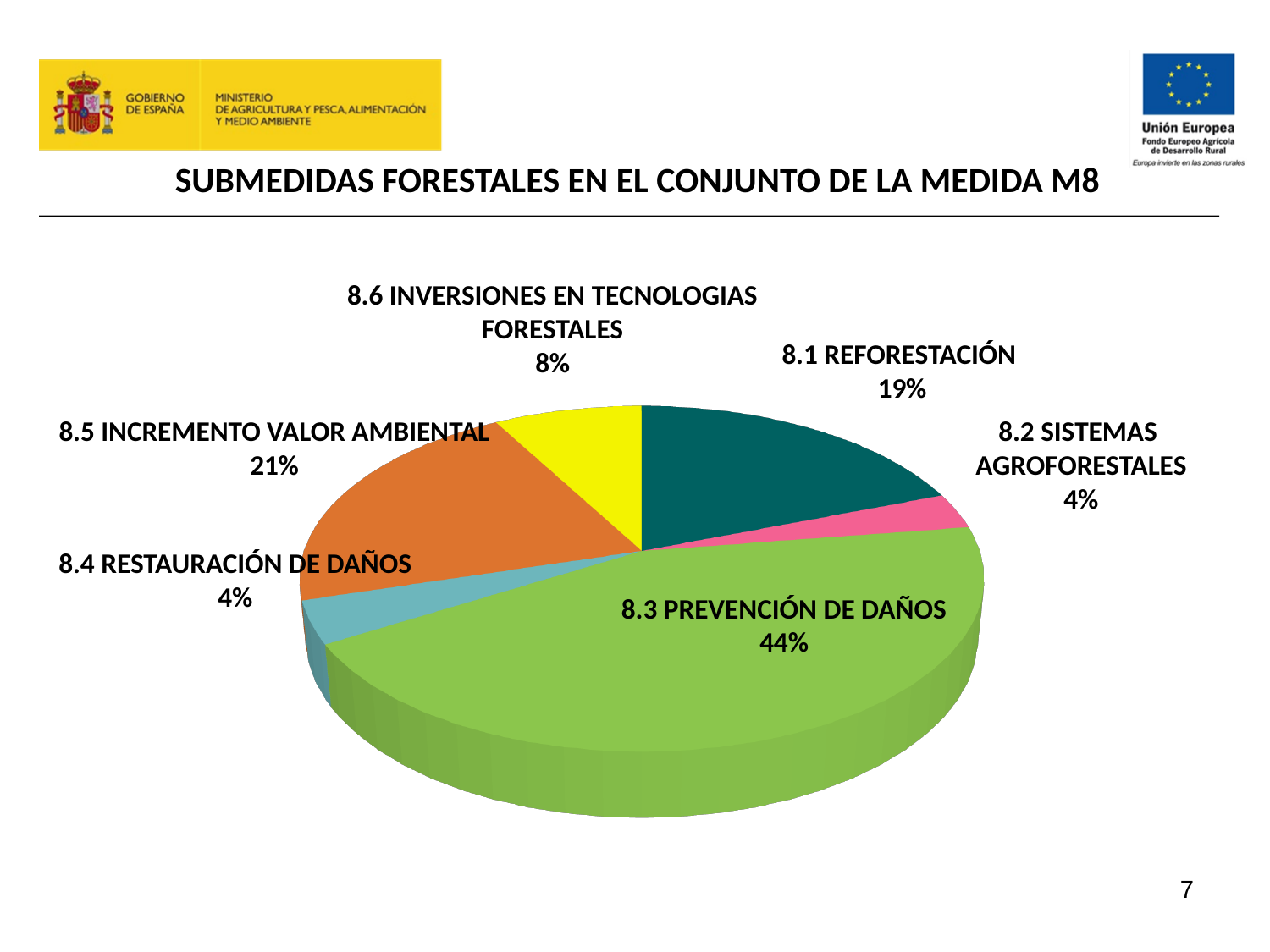
What is the title of the chart? SUBMEDIDAS FORESTALES EN EL CONJUNTO DE LA MEDIDA M8 What kind of chart is shown on the slide? Pie chart Which submeasure has the largest share of the pie? 8.3 PREVENCIÓN DE DAÑOS What share does 8.6 INVERSIONES EN TECNOLOGIAS FORESTALES have in the pie chart? 8% What share does 8.1 REFORESTACIÓN have in the pie chart? 19% What colour is the slice for 8.3 PREVENCIÓN DE DAÑOS? Green What share does 8.2 SISTEMAS AGROFORESTALES have in the pie chart? 4% What is the difference in percentage points between 8.3 PREVENCIÓN DE DAÑOS and 8.5 INCREMENTO VALOR AMBIENTAL? 23 percentage points Which is larger, the share of 8.1 REFORESTACIÓN or the share of 8.6 INVERSIONES EN TECNOLOGIAS FORESTALES? 8.1 REFORESTACIÓN How many slices does the pie chart have? 6